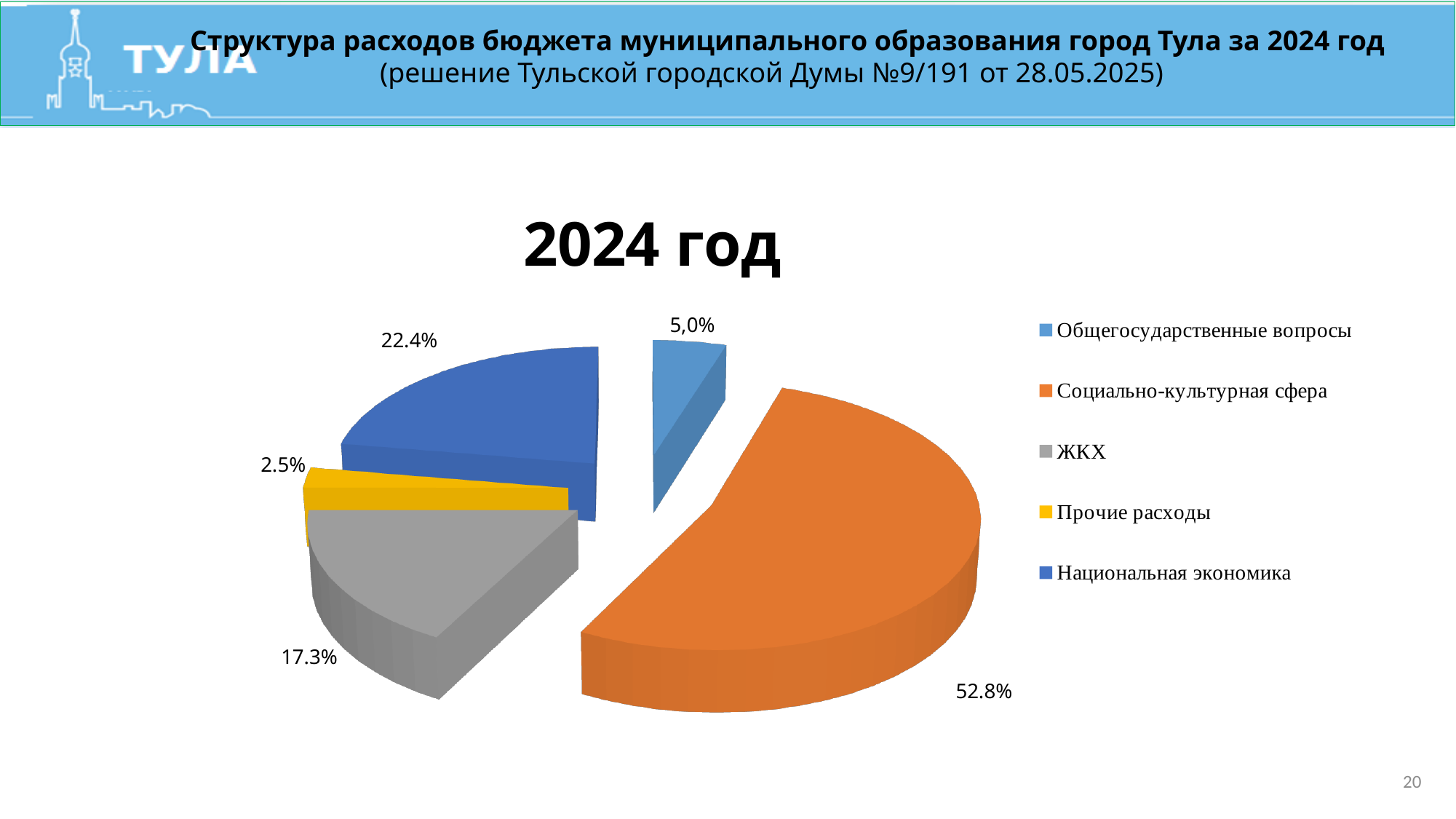
What is the chart's title? 2024 год Which category has the largest share of the pie? Социально-культурная сфера What share of the pie is Социально-культурная сфера? 52.8% How many entries does the legend list? 5 Which category has the smallest share of the pie? Прочие расходы What is the difference between the shares of Национальная экономика and ЖКХ? 5.1% What is the value shown for Общегосударственные вопросы? 5,0% What kind of chart is shown on the slide? pie chart What is the value shown for ЖКХ? 17.3% What is the value shown for Национальная экономика? 22.4% How many slices does the pie chart have? 5 Which is larger, the share of ЖКХ or the share of Национальная экономика? Национальная экономика